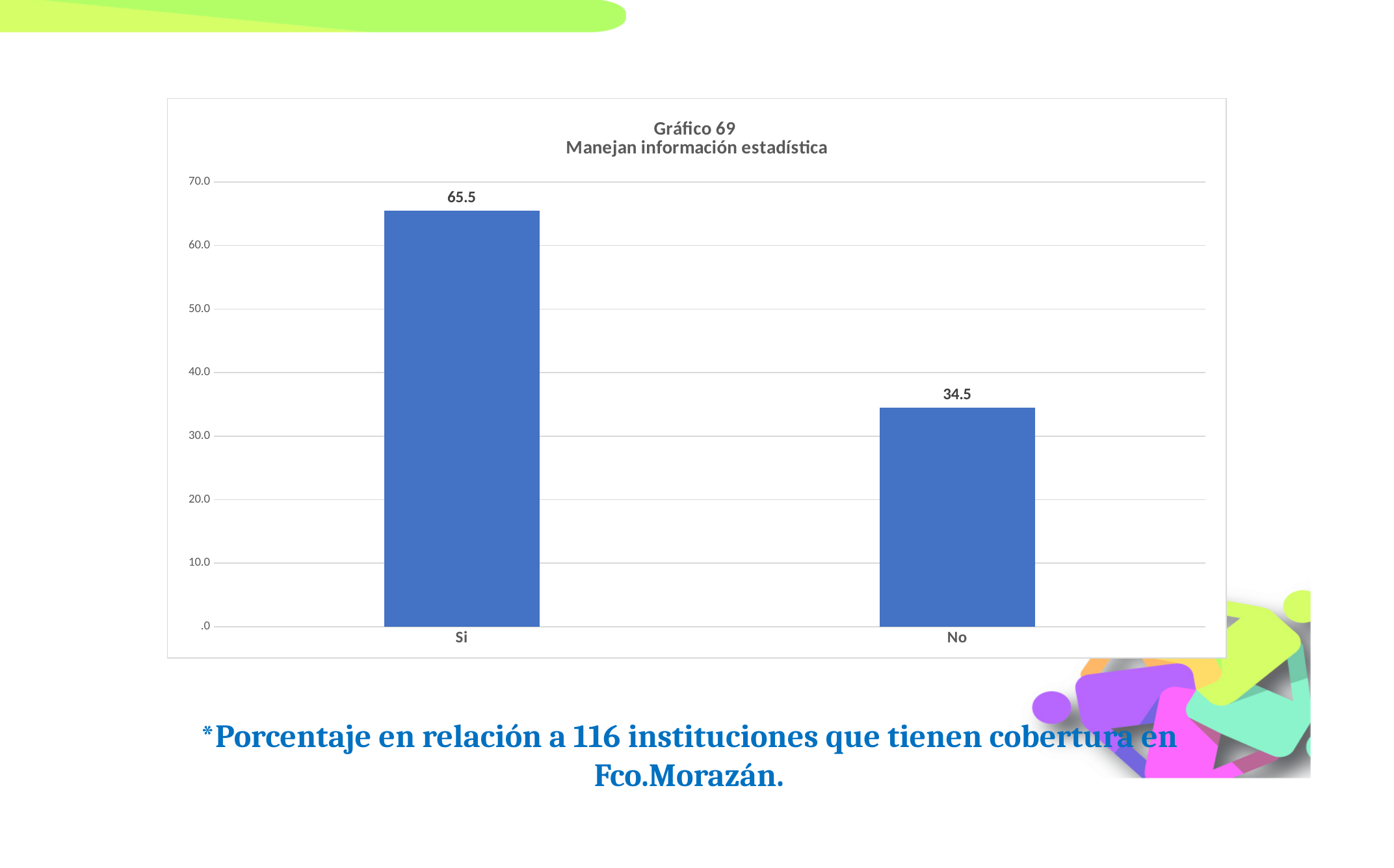
Which category has the highest value? Si What is the value for Si? 65.5 What is the difference between the values for Si and No? 31.0 What kind of chart is shown on the slide? bar chart What is the value for No? 34.5 Which category has the lowest value? No Is the value for Si greater or less than 60.0? greater Is the value for No greater or less than 40.0? less What is the highest value shown on the y axis? 70.0 What is the title of the chart? Gráfico 69 Manejan información estadística How many categories are shown on the x axis? 2 Which is larger, the value for Si or the value for No? Si